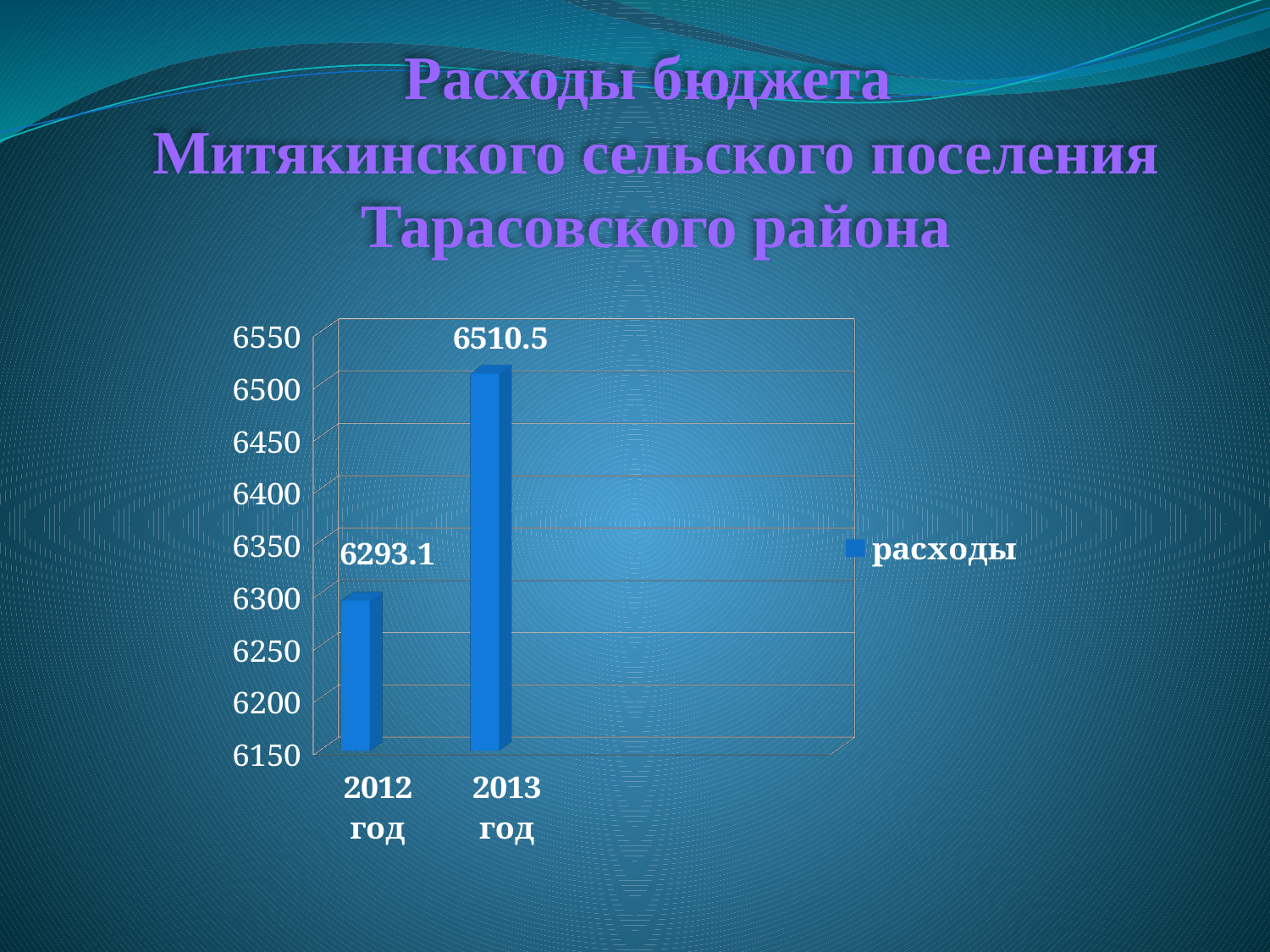
Which year has the lowest value? 2012 год What is the value for 2012 год? 6293.1 Which year has the highest value? 2013 год What is the value for 2013 год? 6510.5 Is the value for 2013 год greater or less than 6500? greater What kind of chart is shown? bar chart What is the name of the series in the legend? расходы How many categories are shown on the x axis? 2 Which is larger, the value for 2012 год or 2013 год? 2013 год How many series does the legend list? 1 Is the value for 2012 год greater or less than 6300? less What is the difference between the values for 2013 год and 2012 год? 217.4